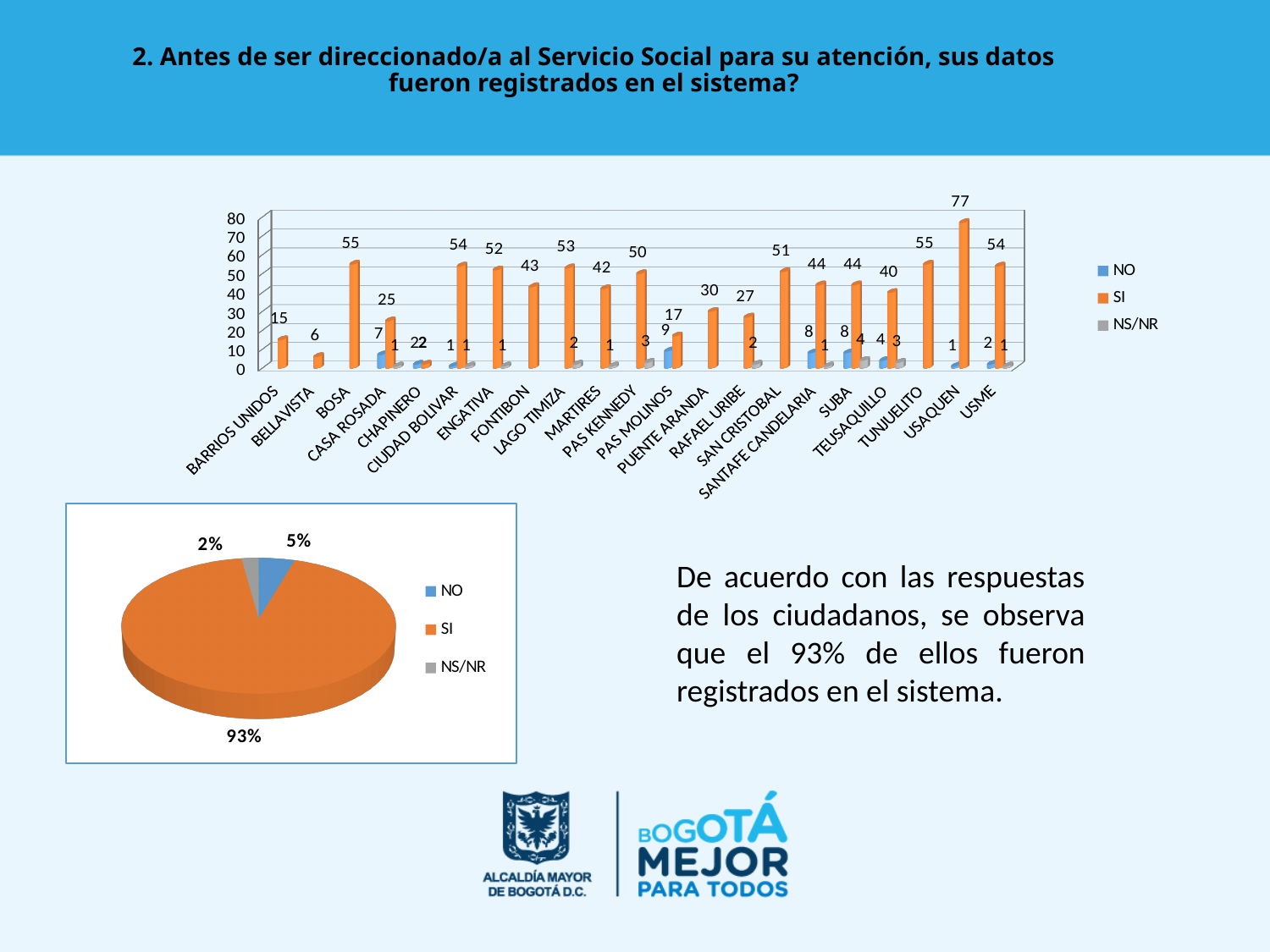
What kind of chart is the top chart on the slide? Bar chart How many series does the legend of the top bar chart list? 3 How many categories are shown on the x axis of the top bar chart? 21 In the top bar chart, which has a larger SI value, ENGATIVA or PUENTE ARANDA? ENGATIVA In the pie chart at the bottom left, what is the value for NO? 5% In the pie chart at the bottom left, what share does SI have? 93% In the top bar chart, what is the SI value for USAQUEN? 77 In the top bar chart, which category has the highest SI value? USAQUEN In the top bar chart, what is the difference between the SI values for BOSA and FONTIBON? 12 In the top bar chart, what is the NO value for PAS MOLINOS? 9 In the top bar chart, which category has the lowest SI value? CHAPINERO In the top bar chart, what is the SI value for FONTIBON? 43